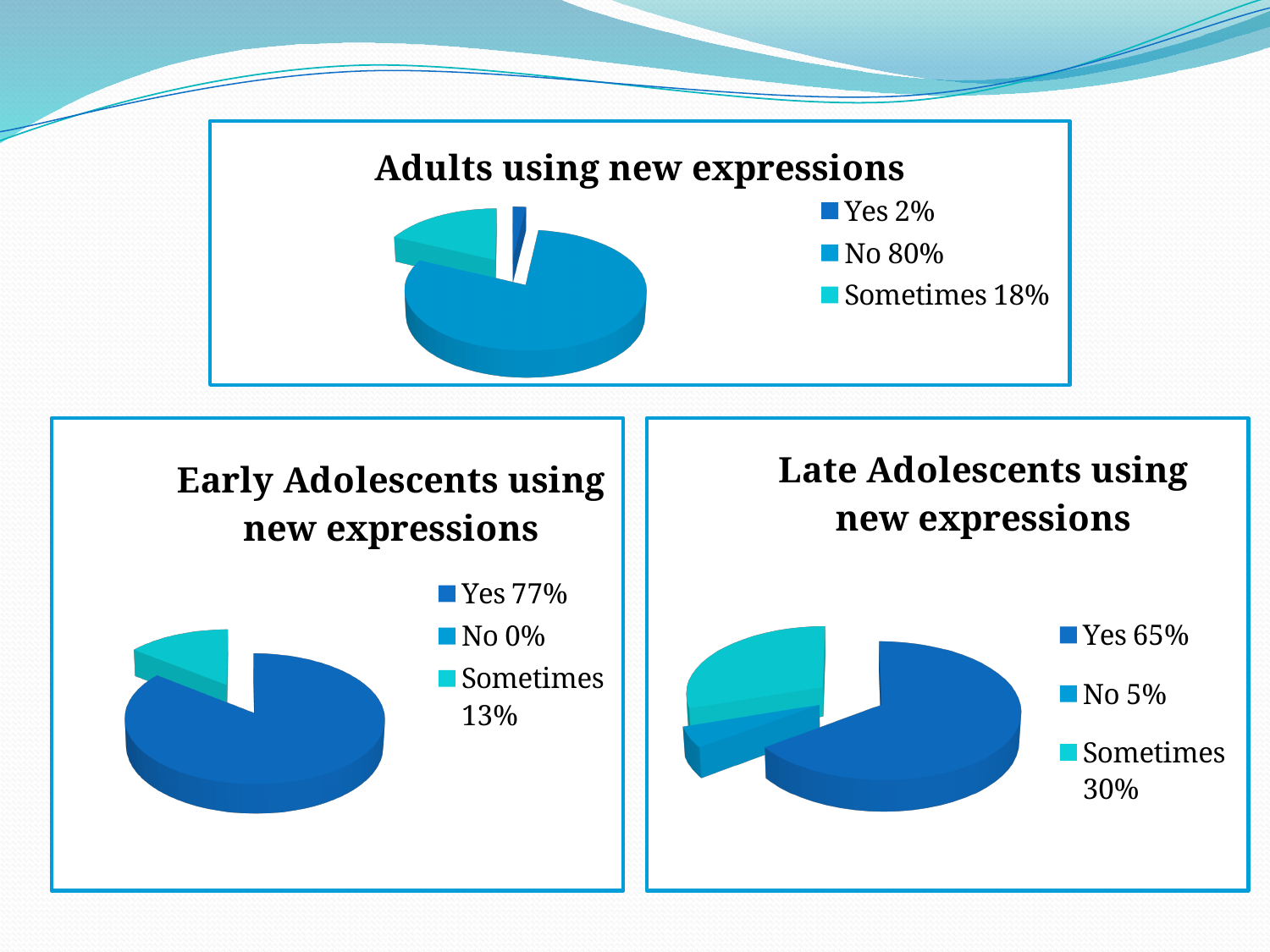
In the 'Late Adolescents using new expressions' chart, what percentage answered Sometimes? 30% In the 'Adults using new expressions' chart, what percentage answered No? 80% In the 'Late Adolescents using new expressions' chart, what is the difference between the Yes and Sometimes percentages? 35% In the 'Early Adolescents using new expressions' chart, what percentage answered Yes? 77% In the 'Adults using new expressions' chart, which response has the largest share? No In the 'Adults using new expressions' chart, what percentage answered Sometimes? 18% What type of chart is 'Adults using new expressions'? Pie chart In the 'Early Adolescents using new expressions' chart, which response has the smallest share? No How many categories does the legend of the 'Late Adolescents using new expressions' chart list? 3 In the 'Late Adolescents using new expressions' chart, which response has the largest share? Yes How many pie charts are shown on the slide? 3 Is the Yes share larger in the 'Early Adolescents using new expressions' chart or the 'Late Adolescents using new expressions' chart? Early Adolescents using new expressions